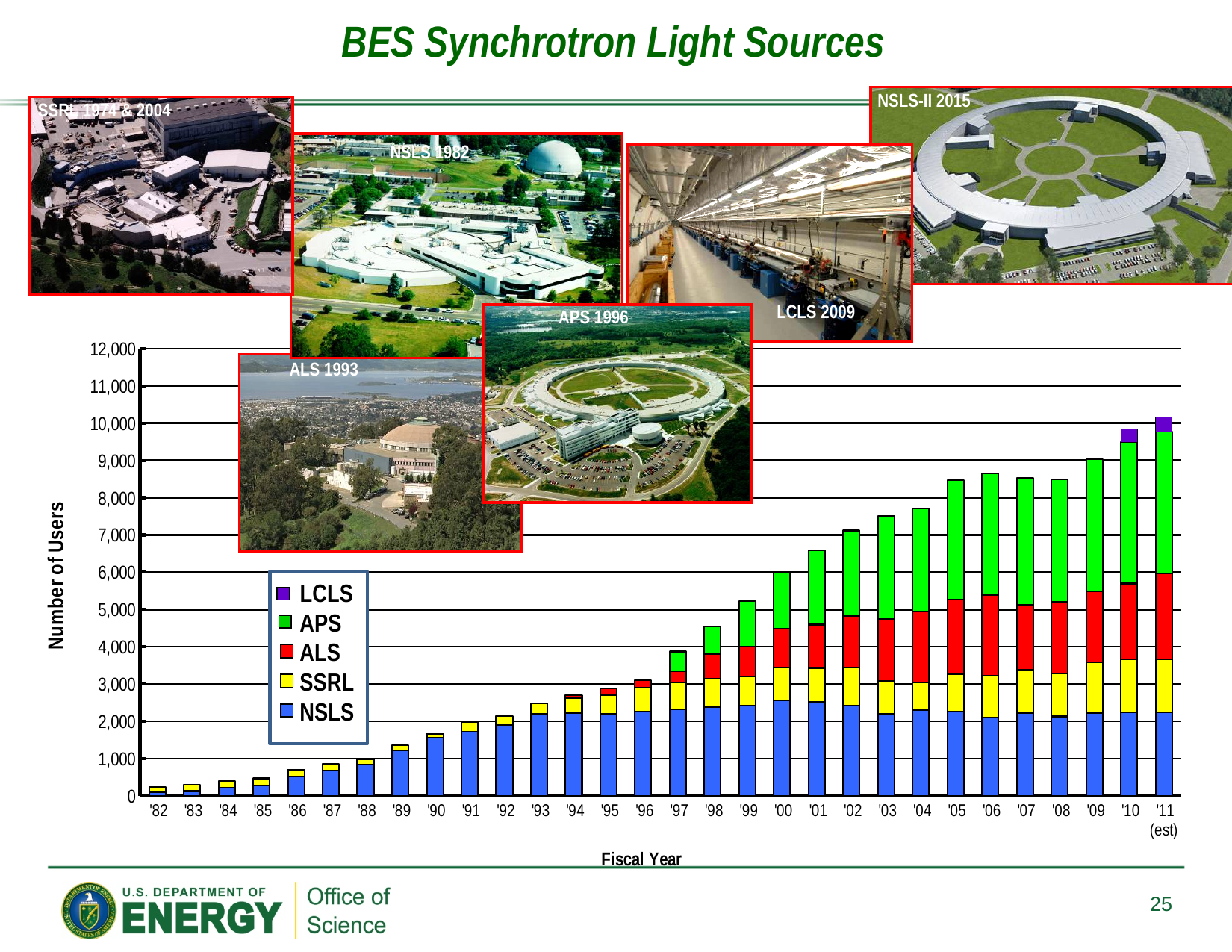
Is the total number of users for '82 greater or less than 1,000? less Which series in the legend is shown in purple? LCLS How many series does the chart legend list? 5 Which fiscal year has the lowest total number of users? '82 Is the total number of users for '94 greater or less than 3,000? less What kind of chart is shown on the slide? stacked bar chart Which fiscal year has the highest total number of users? '11 (est) Which fiscal year has the larger total number of users, '08 or '09? '09 How many fiscal years are shown along the x axis of the chart? 30 Does the total number of users generally rise or fall from '82 to '11? rise Is the total number of users for '03 greater or less than 7,000? greater